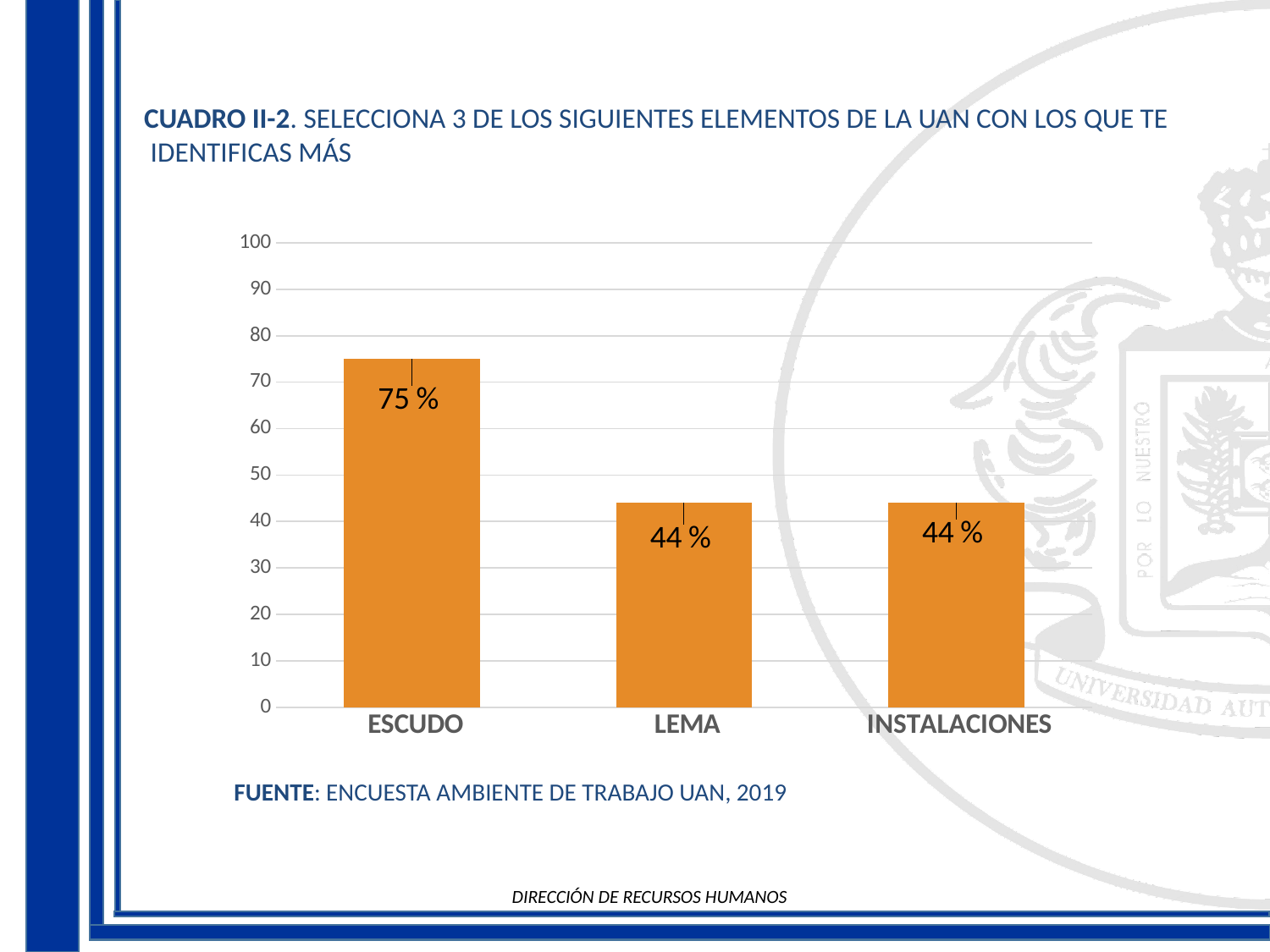
What is the value for INSTALACIONES? 44 % Is the value for LEMA greater or less than 50? less Is the value for ESCUDO greater or less than 70? greater How many categories are shown on the x axis? 3 What kind of chart is shown on the slide? bar chart What is the value for ESCUDO? 75 % What is the value for LEMA? 44 % Which is larger, the value for ESCUDO or the value for INSTALACIONES? ESCUDO Which category has the highest value? ESCUDO What is the highest value shown on the y axis? 100 What source is cited below the chart? ENCUESTA AMBIENTE DE TRABAJO UAN, 2019 What is the difference between the values for ESCUDO and LEMA? 31 %